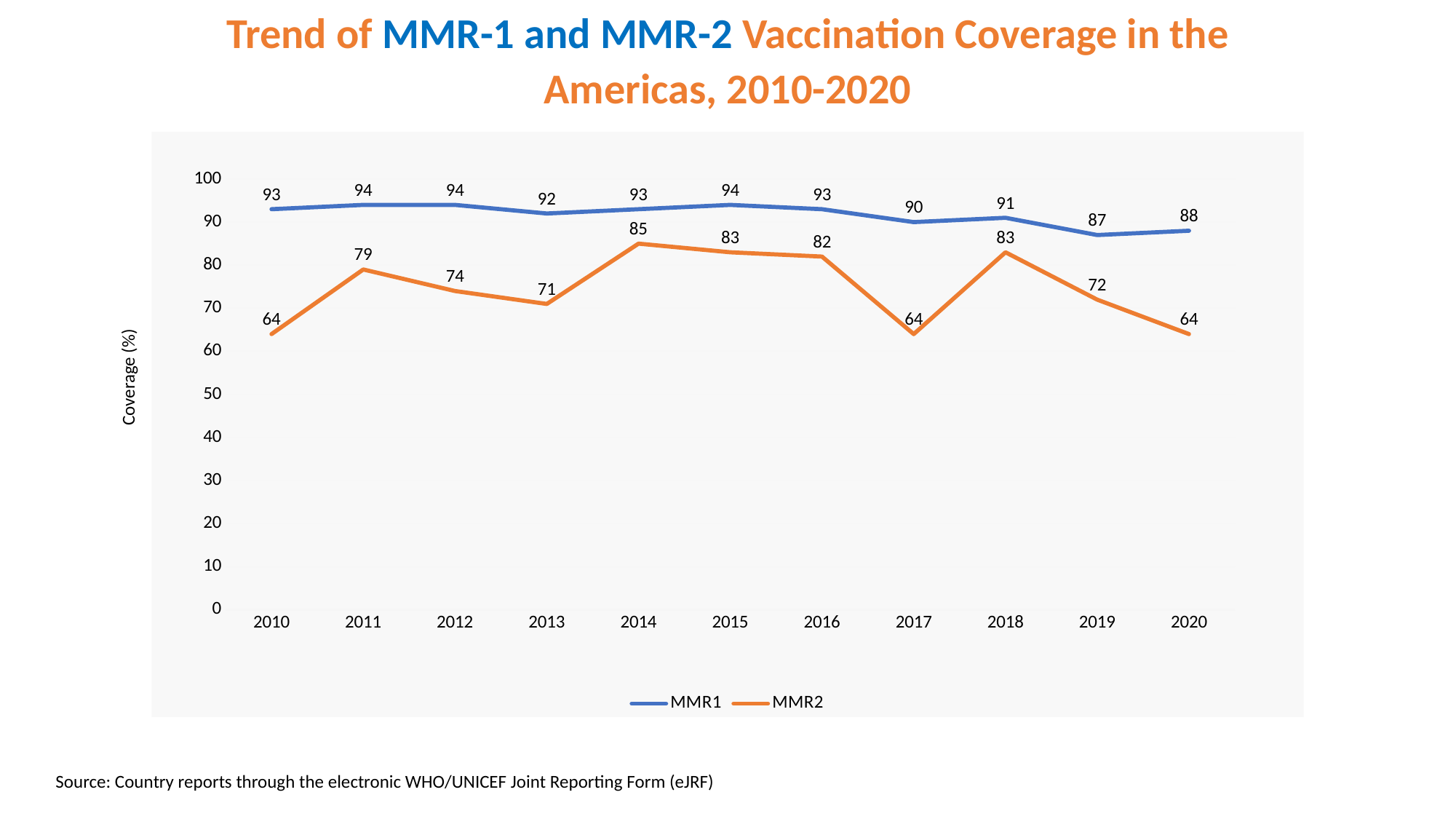
Is the MMR2 value for 2018 greater or less than 80? greater In which year is MMR1 coverage lowest? 2019 What is the MMR1 coverage value for 2015? 94 In which year is MMR2 coverage highest? 2014 What is the MMR2 coverage value for 2014? 85 What kind of chart is shown on the slide? Line chart What is the MMR2 coverage value for 2020? 64 How many years are shown on the x axis? 11 How many series does the legend list? 2 Which is larger, MMR2 coverage in 2011 or MMR2 coverage in 2013? 2011 What is the label of the y axis? Coverage (%) What is the difference between MMR1 and MMR2 coverage in 2017? 26